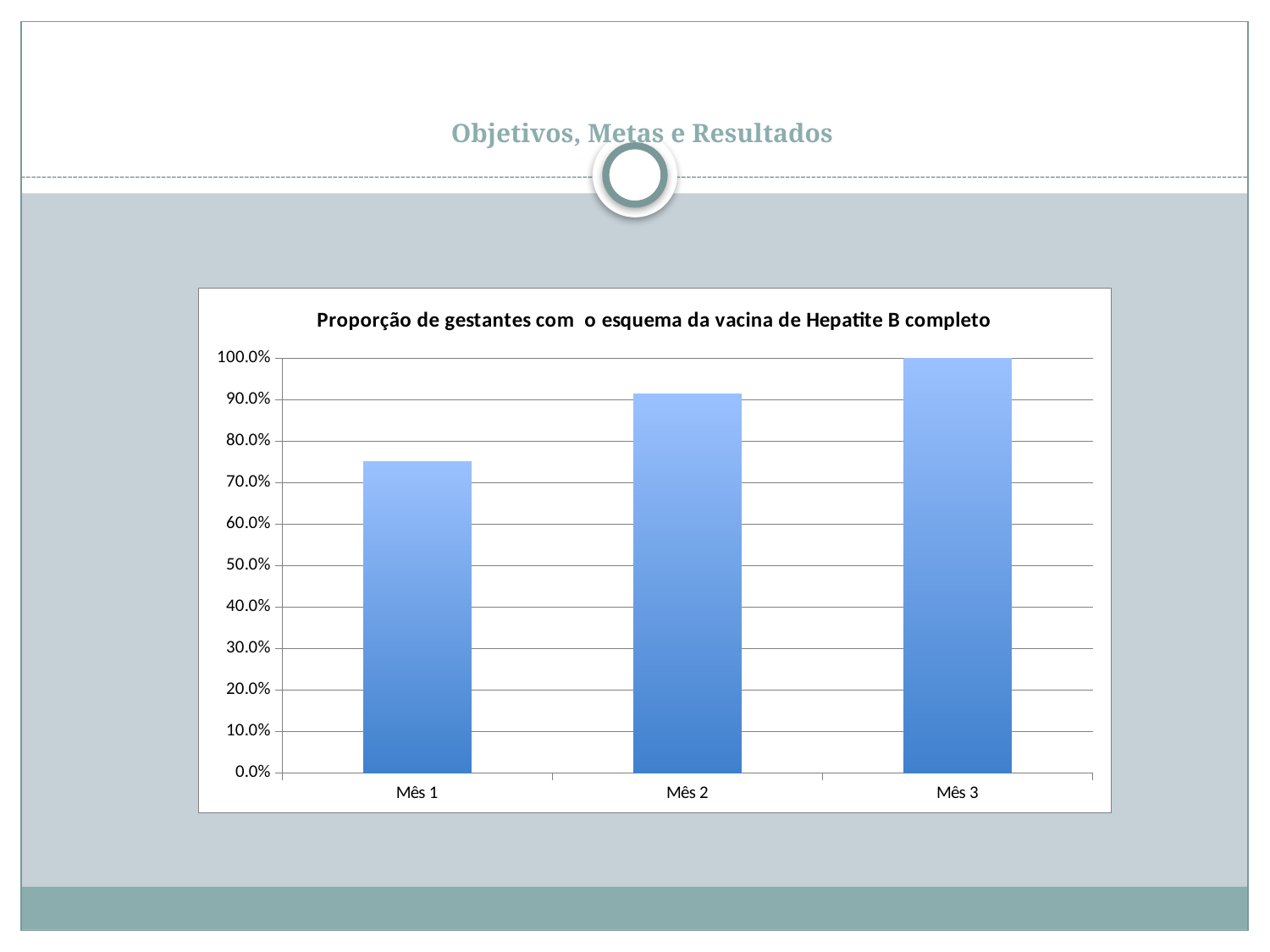
What is the value for Mês 3 in the chart? 100.0% Is the value for Mês 1 greater or less than 80.0%? less Is the value for Mês 1 greater or less than 70.0%? greater What is the title of the chart? Proporção de gestantes com o esquema da vacina de Hepatite B completo What is the highest value shown on the y axis of the chart? 100.0% What type of chart is shown on the slide? bar chart Which month has the highest proportion in the chart? Mês 3 Which month has the lowest proportion in the chart? Mês 1 Do the values rise or fall from Mês 1 to Mês 3? rise Is the value for Mês 2 greater or less than 90.0%? greater Which is larger, the value for Mês 1 or the value for Mês 2? Mês 2 How many categories are shown on the x axis of the chart? 3